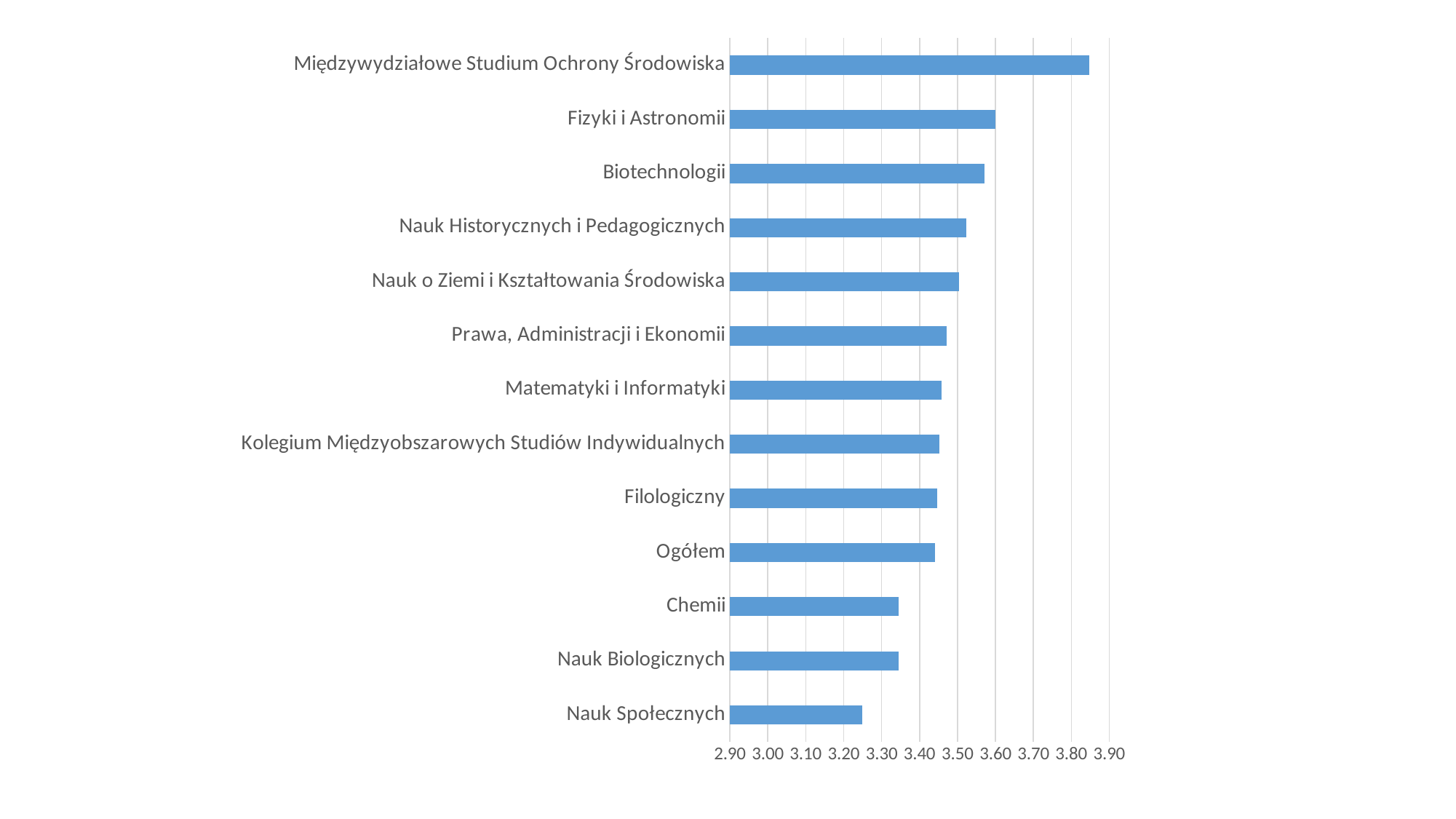
Is the value for Biotechnologii greater or less than 3.50? greater Is the value for Nauk Społecznych greater or less than 3.30? less Is the value for Międzywydziałowe Studium Ochrony Środowiska greater or less than 3.80? greater Which category has the lowest value? Nauk Społecznych What kind of chart is shown on the slide? bar chart Which category has the highest value? Międzywydziałowe Studium Ochrony Środowiska How many categories are plotted in the chart? 13 Which has a larger value, Fizyki i Astronomii or Chemii? Fizyki i Astronomii Which has a larger value, Nauk Społecznych or Biotechnologii? Biotechnologii